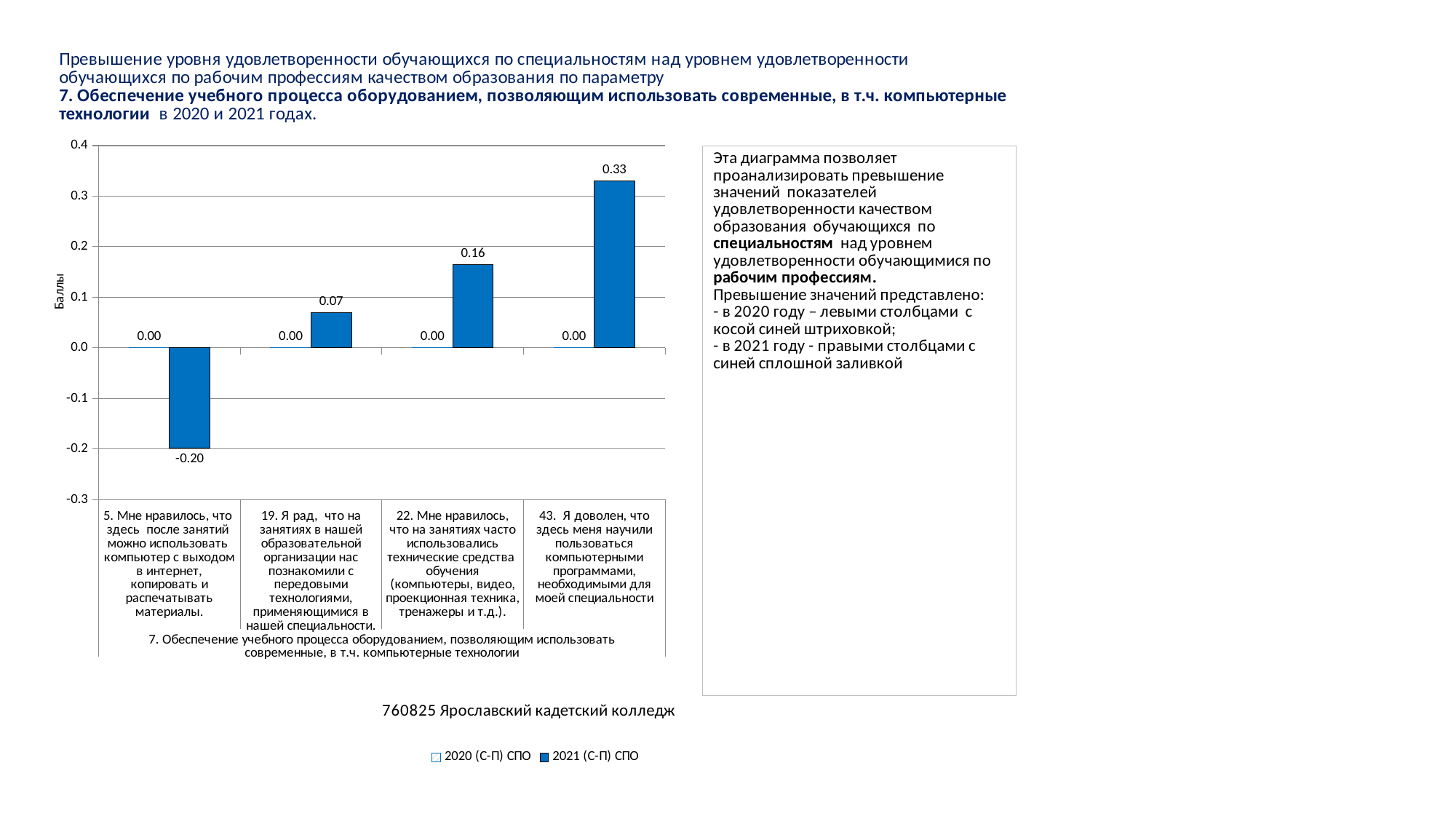
What is the label of the vertical axis of the chart? Баллы Which category has the highest value in the 2021 (С-П) СПО series? 43. Я доволен, что здесь меня научили пользоваться компьютерными программами, необходимыми для моей специальности What is the value of the 2021 (С-П) СПО series for category 19 (Я рад, что на занятиях в нашей образовательной организации нас познакомили с передовыми технологиями)? 0.07 What is the value of the 2020 (С-П) СПО series for category 22 (Мне нравилось, что на занятиях часто использовались технические средства обучения)? 0.00 How many series does the chart legend list? 2 Which is larger in the 2021 (С-П) СПО series: the value for category 19 or the value for category 22? Category 22 What is the value of the 2021 (С-П) СПО series for category 43 (Я доволен, что здесь меня научили пользоваться компьютерными программами)? 0.33 What is the value of the 2021 (С-П) СПО series for category 5 (Мне нравилось, что здесь после занятий можно использовать компьютер с выходом в интернет)? -0.20 What type of chart is shown on the slide? Bar chart How many categories are shown on the x axis of the chart? 4 What is the difference between the 2021 (С-П) СПО values for category 43 and category 22? 0.17 Which category has the lowest value in the 2021 (С-П) СПО series? 5. Мне нравилось, что здесь после занятий можно использовать компьютер с выходом в интернет, копировать и распечатывать материалы.